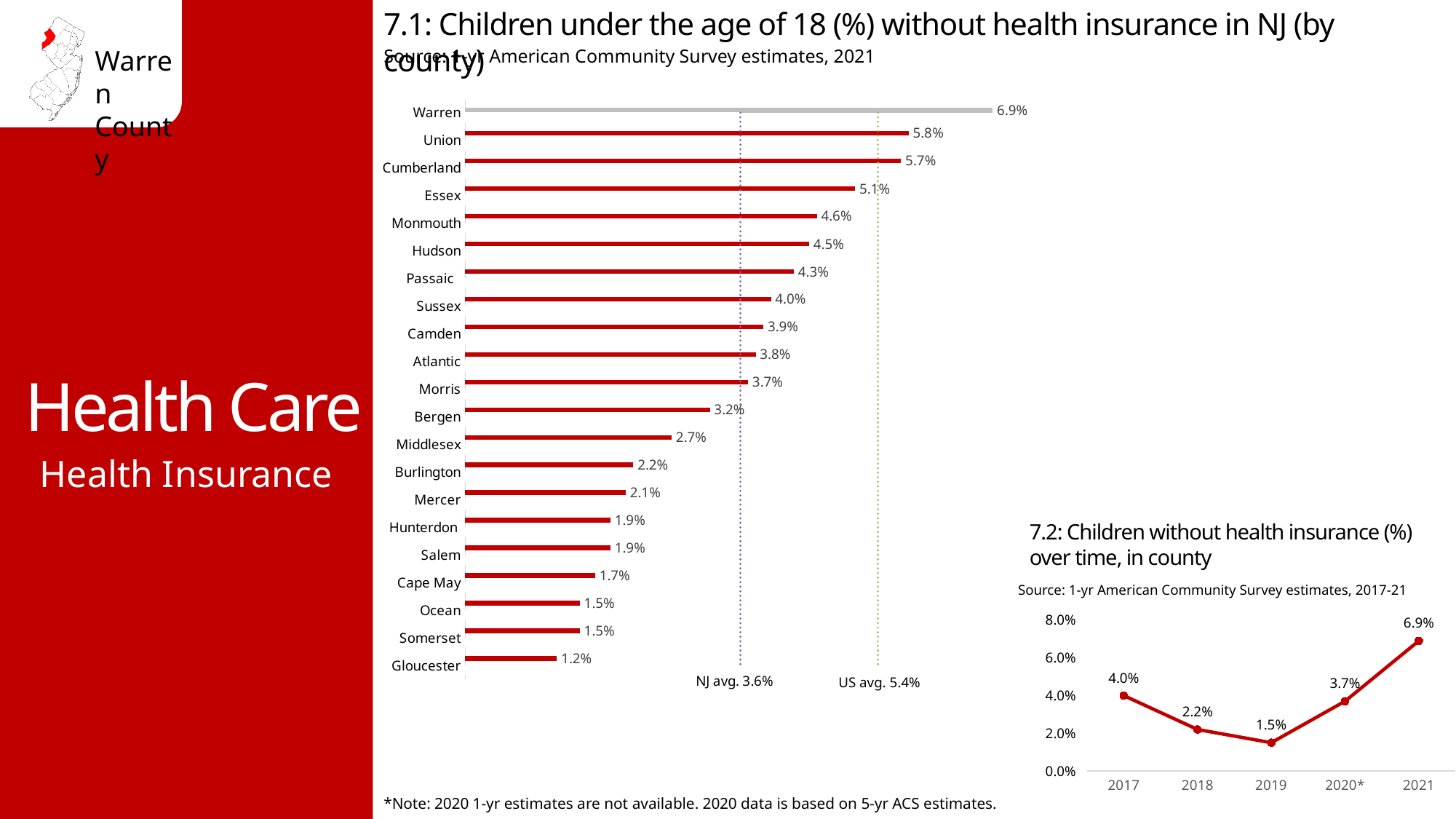
In chart 7.1 (children under 18 without health insurance by county), what is the value for Warren? 6.9% In chart 7.2, which year has the highest value? 2021 In chart 7.1, which county has the highest percentage of children without health insurance? Warren In chart 7.1, what is the NJ average shown by the dotted reference line? 3.6% In chart 7.2 (children without health insurance over time), what is the value for 2019? 1.5% In chart 7.1, which county has the lowest percentage of children without health insurance? Gloucester In chart 7.1, what is the difference between the values for Union and Middlesex? 3.1% In chart 7.1, what is the value for Hudson? 4.5% In chart 7.1, how many counties are shown? 21 In chart 7.1, which county has a higher value, Essex or Passaic? Essex In chart 7.2, what is the difference between the 2021 and 2017 values? 2.9% What kind of chart is chart 7.1? Bar chart